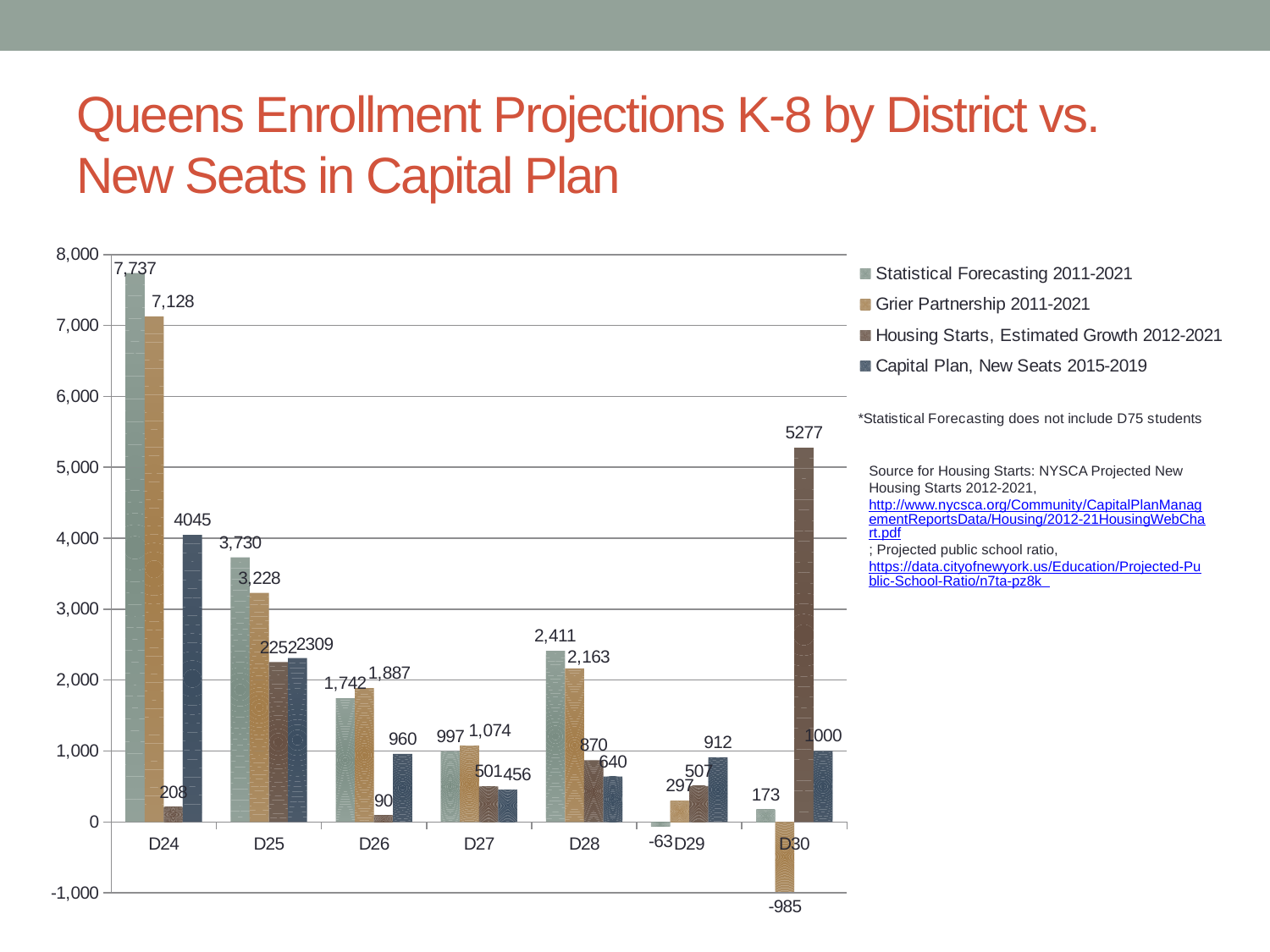
Which district has the highest Housing Starts, Estimated Growth 2012-2021 value? D30 Do the Statistical Forecasting 2011-2021 values rise or fall from D24 to D27? Fall What is the Housing Starts, Estimated Growth 2012-2021 value for D30? 5277 What kind of chart is shown on the slide? Bar chart For D26, which is larger: the Statistical Forecasting value or the Grier Partnership value? Grier Partnership 2011-2021 What is the Statistical Forecasting 2011-2021 value for D24? 7,737 How many series does the legend list? 4 What is the difference between the Housing Starts and Capital Plan values for D30? 4277 What is the Capital Plan, New Seats 2015-2019 value for D24? 4045 How many districts are shown on the x axis? 7 Which district has the lowest Grier Partnership 2011-2021 value? D30 What is the difference between the Statistical Forecasting and Grier Partnership values for D24? 609